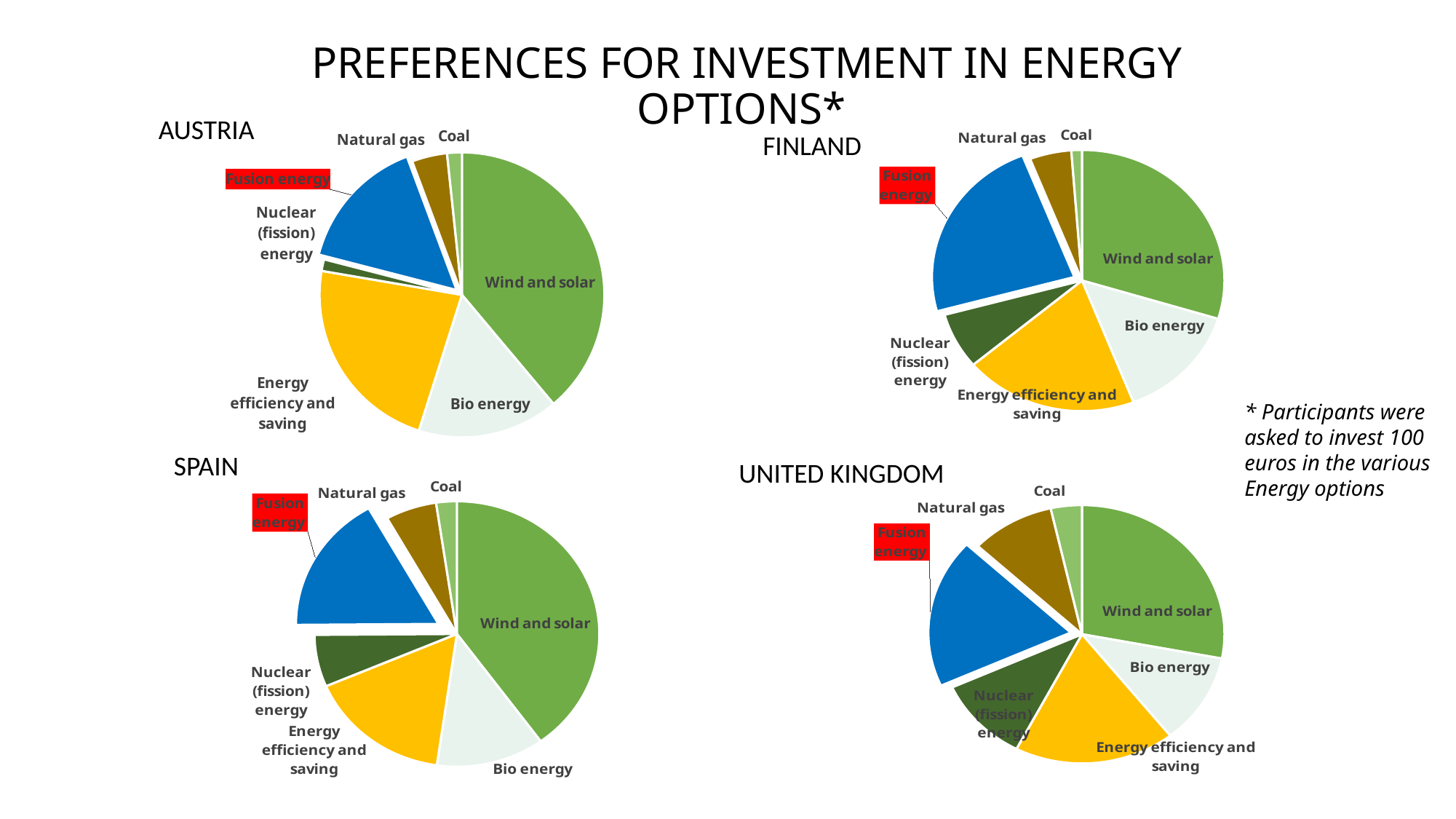
In the Finland chart, how many energy options (slices) are shown? 7 In the Spain chart, which energy option has the largest slice? Wind and solar In the United Kingdom chart, which slice is larger: Natural gas or Coal? Natural gas Which energy option label is highlighted with a red box in all four charts? Fusion energy According to the footnote, how many euros were participants asked to invest? 100 euros In the Finland chart, which energy option has the smallest slice? Coal How many pie charts are shown on the slide? 4 In the United Kingdom chart, which energy option has the largest slice? Wind and solar In the Austria chart, which slice is larger: Fusion energy or Nuclear (fission) energy? Fusion energy What kind of chart is used for Austria? Pie chart In the Austria chart, which energy option has the smallest slice? Nuclear (fission) energy In the Austria chart, which energy option has the largest slice? Wind and solar